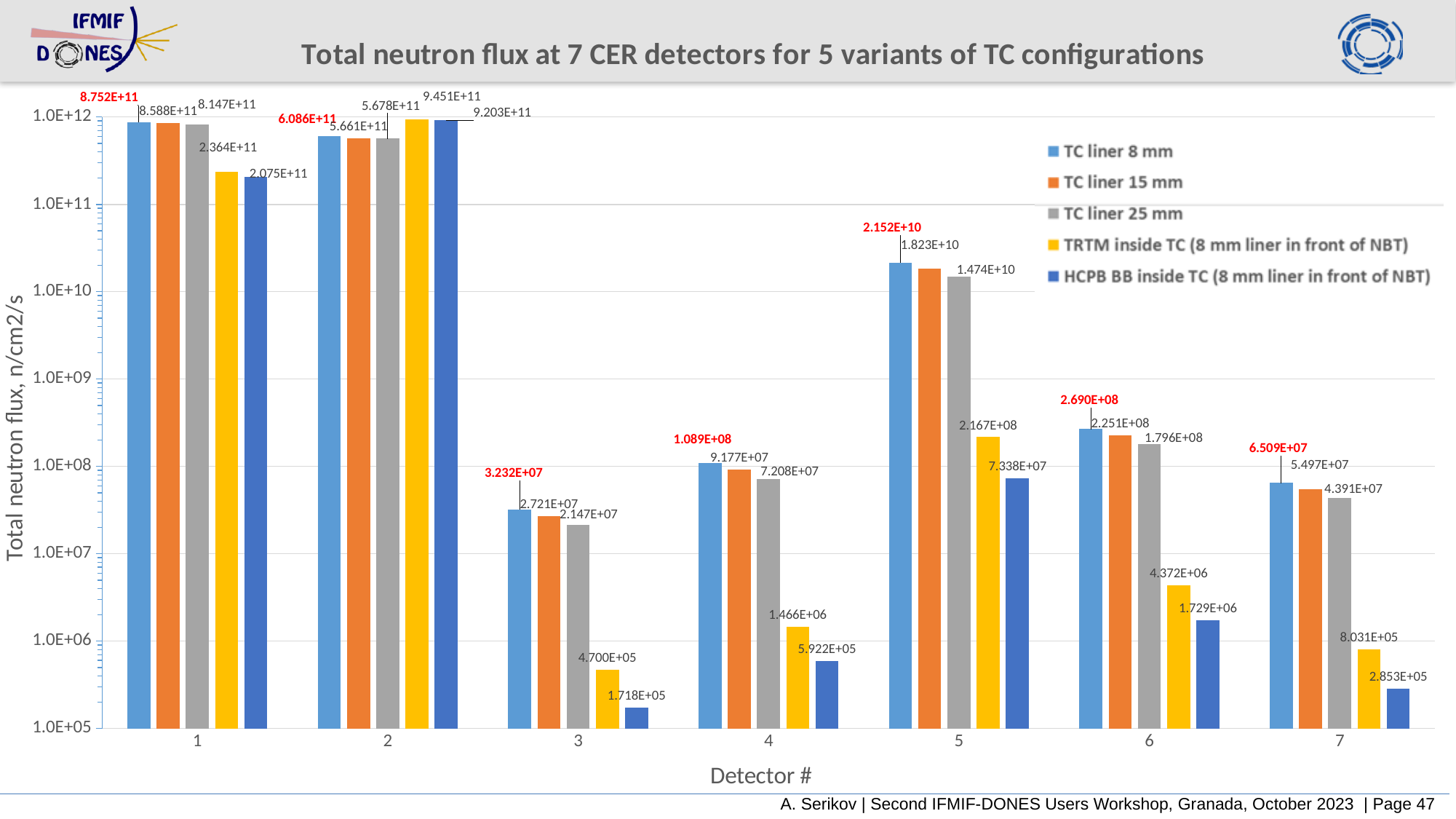
What type of chart is shown on the slide? bar chart What is the total neutron flux at detector 1 for the TC liner 8 mm configuration? 8.752E+11 Is the total neutron flux at detector 4 for the TC liner 8 mm configuration greater or less than 1.0E+08? greater What is the total neutron flux at detector 5 for the TRTM inside TC (8 mm liner in front of NBT) configuration? 2.167E+08 At detector 6, is the total neutron flux for TC liner 8 mm larger or smaller than for TC liner 25 mm? larger What is the total neutron flux at detector 7 for the TC liner 25 mm configuration? 4.391E+07 What is the total neutron flux at detector 3 for the HCPB BB inside TC (8 mm liner in front of NBT) configuration? 1.718E+05 At detector 2, which configuration has the highest total neutron flux? TRTM inside TC (8 mm liner in front of NBT) How many detectors are shown on the x axis? 7 How many configurations does the legend list? 5 Which detector has the highest total neutron flux for the TRTM inside TC (8 mm liner in front of NBT) configuration? 2 Which detector has the lowest total neutron flux for the TC liner 8 mm configuration? 3